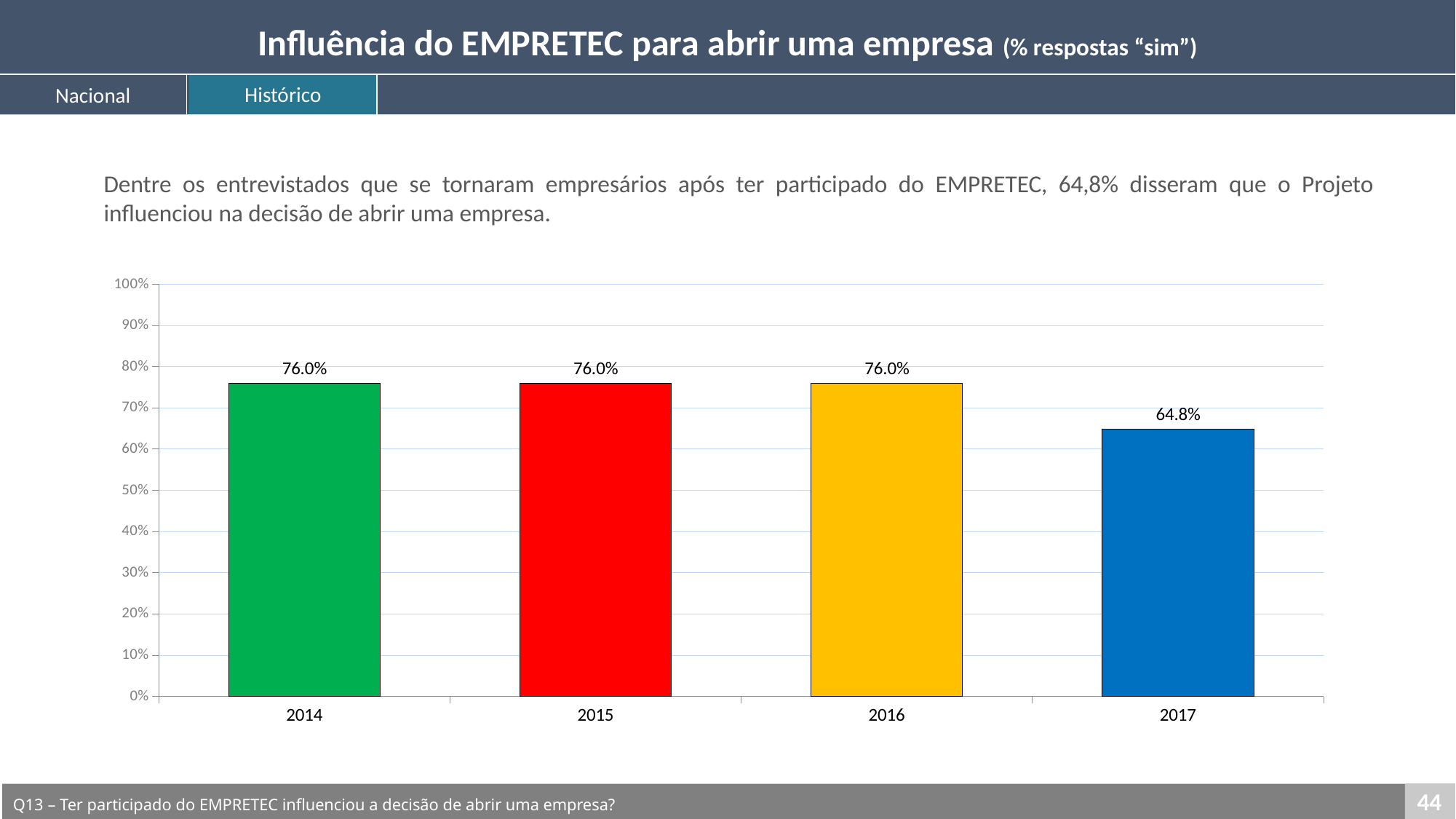
How many years are shown on the x axis? 4 Is the value for 2014 greater or less than 70%? greater What colour is the bar for 2015? red What is the value for 2014? 76.0% Which is larger, the value for 2015 or the value for 2017? 2015 What is the value for 2017? 64.8% What kind of chart is shown on the slide? bar chart Which year has the lowest value? 2017 What is the value for 2016? 76.0% Do the values rise or fall from 2016 to 2017? fall What is the difference between the values for 2016 and 2017? 11.2% Is the value for 2017 greater or less than 70%? less